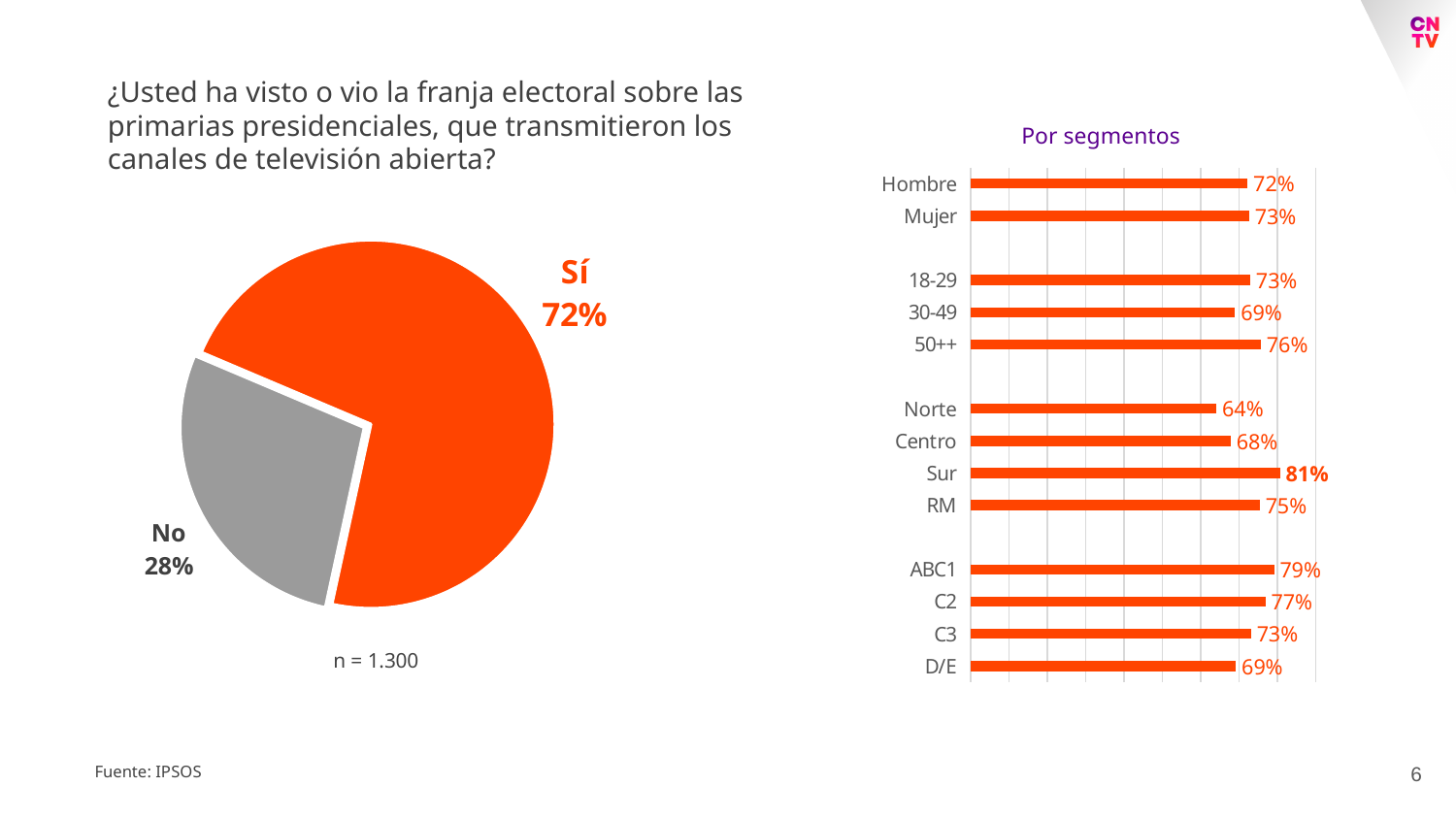
What is the sample size (n) shown under the pie chart? n = 1.300 In the "Por segmentos" chart, which segment has the lowest value? Norte In the "Por segmentos" chart, how many segments are plotted? 13 In the pie chart on the left, what share of respondents answered "Sí"? 72% In the "Por segmentos" chart, what is the value for 30-49? 69% In the "Por segmentos" chart, what is the difference between the values for Sur and Norte? 17% In the pie chart on the left, what share of respondents answered "No"? 28% In the "Por segmentos" chart, which is larger, the value for ABC1 or the value for C2? ABC1 In the "Por segmentos" chart, which segment has the highest value? Sur In the "Por segmentos" chart, what is the difference between the values for Mujer and Hombre? 1% In the "Por segmentos" chart, what is the value for Sur? 81% What kind of chart is the "Por segmentos" chart on the right? bar chart